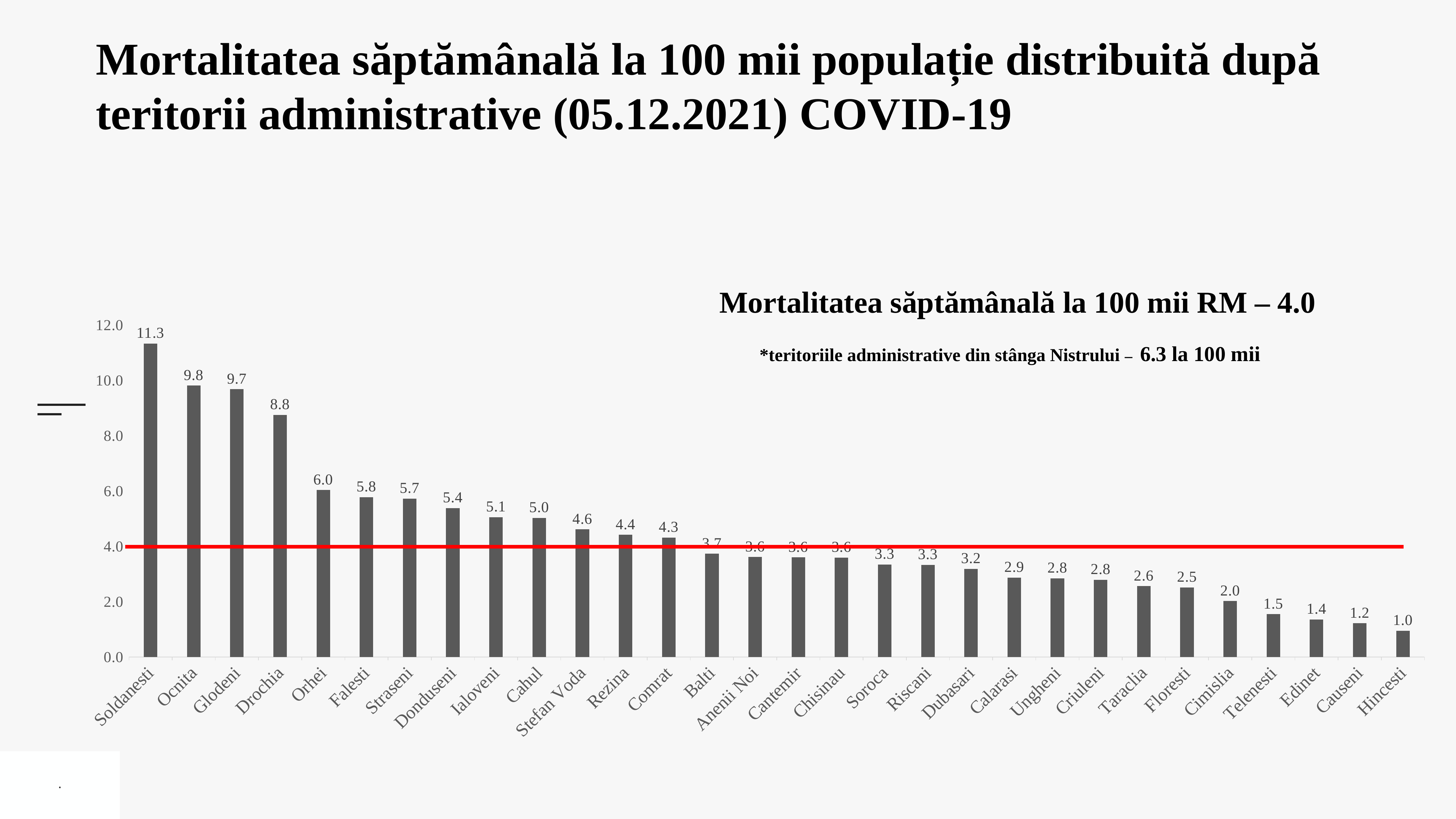
Is the value for Glodeni greater or less than 8.0? greater Which territory has the lowest weekly mortality? Hincesti What is the value shown for Cahul? 5.0 What is the value shown for Chisinau? 3.6 What is the difference between the values for Drochia and Orhei? 2.8 What is the weekly mortality value for Soldanesti? 11.3 What is the difference between the values for Soldanesti and Ocnita? 1.5 How many territories are shown on the x axis? 30 Which has a higher value, Balti or Comrat? Comrat What kind of chart is shown on the slide? bar chart What value does the red horizontal line mark on the chart? 4.0 Which territory has the highest weekly mortality? Soldanesti